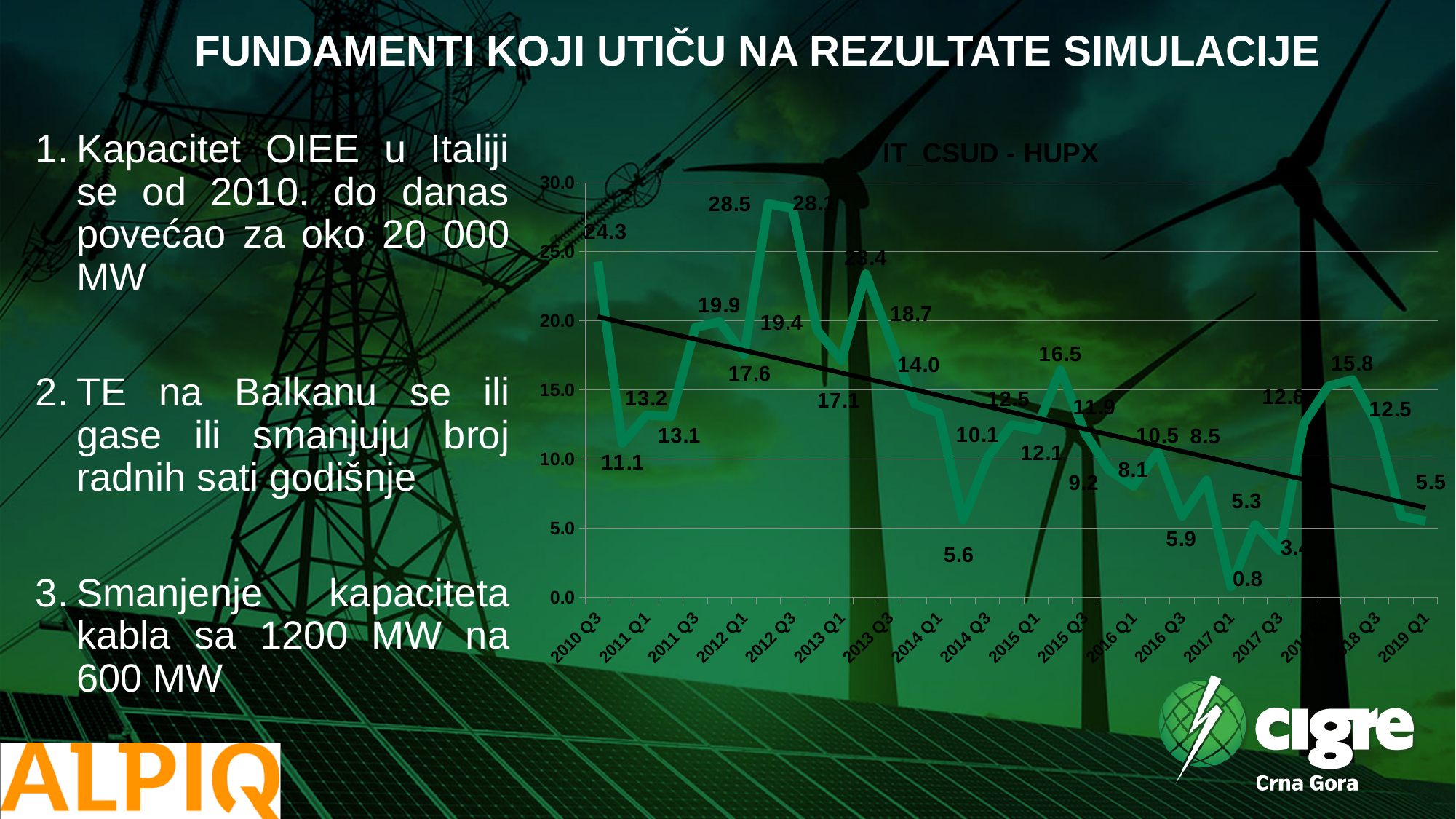
What is the highest value labelled on the IT_CSUD - HUPX line? 28.5 Which is larger: the value at 2010 Q3 or the value at 2019 Q1? 2010 Q3 What is the maximum value shown on the vertical axis of the chart? 30.0 Does the black trend line in the chart rise or fall from left to right? fall What is the title of the chart? IT_CSUD - HUPX What is the lowest value labelled on the IT_CSUD - HUPX line? 0.8 Is the value at 2019 Q1 greater or less than 10.0? less What is the value of the first data point (2010 Q3) in the IT_CSUD - HUPX chart? 24.3 What is the difference between the highest labelled value (28.5) and the lowest labelled value (0.8) in the chart? 27.7 What is the value of the last data point (2019 Q1) in the IT_CSUD - HUPX chart? 5.5 What type of chart is shown on the slide? line chart What is the difference between the first data point (24.3) and the last data point (5.5) in the chart? 18.8